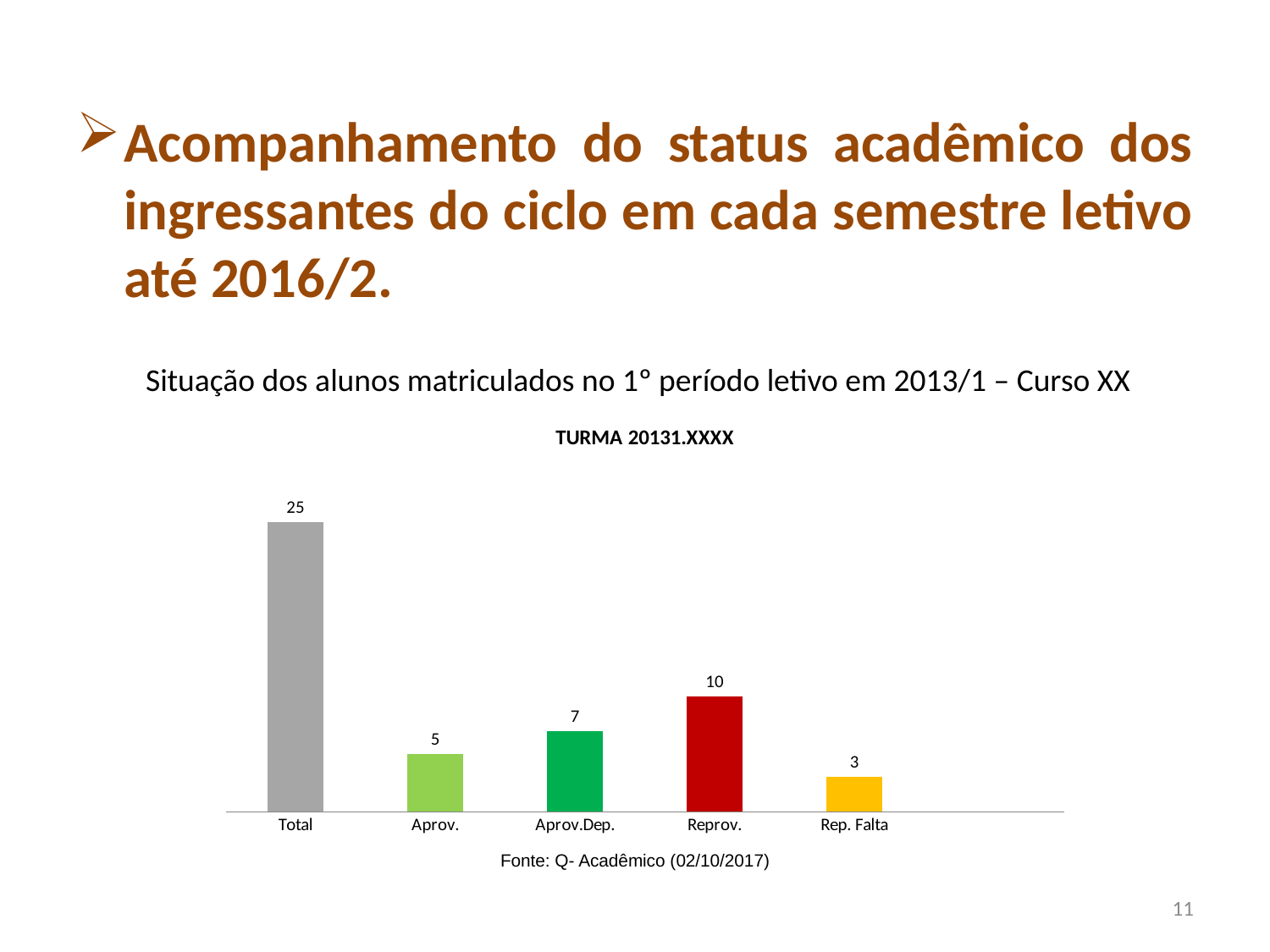
Which category has the highest value? Total What is the value for Rep. Falta? 3 Which category has the lowest value? Rep. Falta What is the value for Aprov.? 5 What is the value for Reprov.? 10 Which is larger, the value for Aprov.Dep. or the value for Reprov.? Reprov. What is the value for Total? 25 What kind of chart is shown? Bar chart What is the value for Aprov.Dep.? 7 What is the title of the chart? TURMA 20131.XXXX What is the difference between the values for Reprov. and Aprov.? 5 How many categories are shown on the x axis? 5